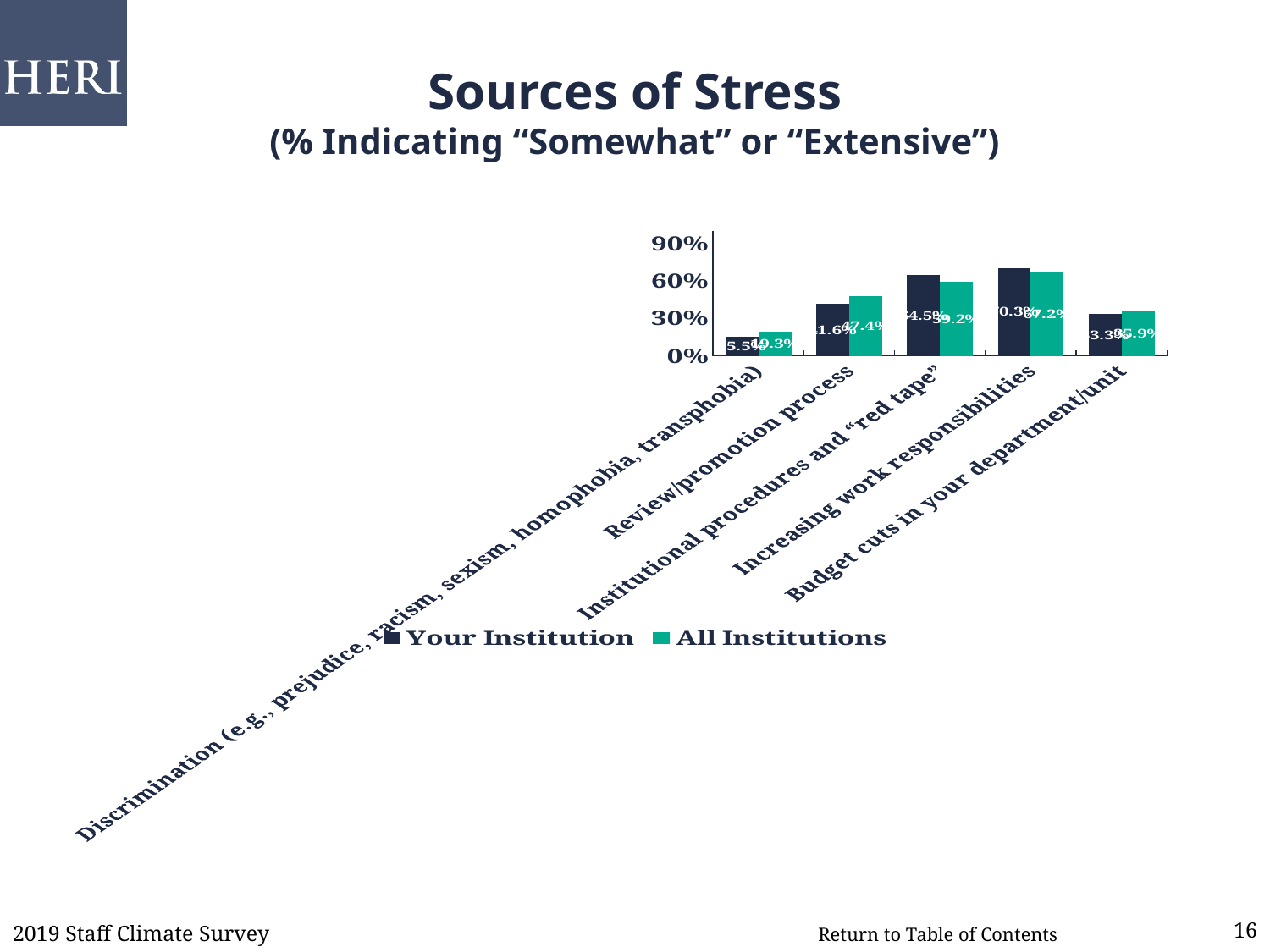
What is the All Institutions value for Review/promotion process? 47.4% What kind of chart is shown on the slide? bar chart Which source of stress has the highest All Institutions value? Increasing work responsibilities Is the Your Institution value for Increasing work responsibilities greater or less than 60%? greater How many series does the legend list? 2 What is the All Institutions value for Institutional procedures and "red tape"? 59.2% Which source of stress has the lowest All Institutions value? Discrimination (e.g., prejudice, racism, sexism, homophobia, transphobia) How many sources of stress (categories) are plotted on the chart? 5 What is the All Institutions value for Budget cuts in your department/unit? 35.9% For Review/promotion process, which series has the larger value, Your Institution or All Institutions? All Institutions What is the All Institutions value for Increasing work responsibilities? 67.2% Is the Your Institution value for Discrimination greater or less than 30%? less